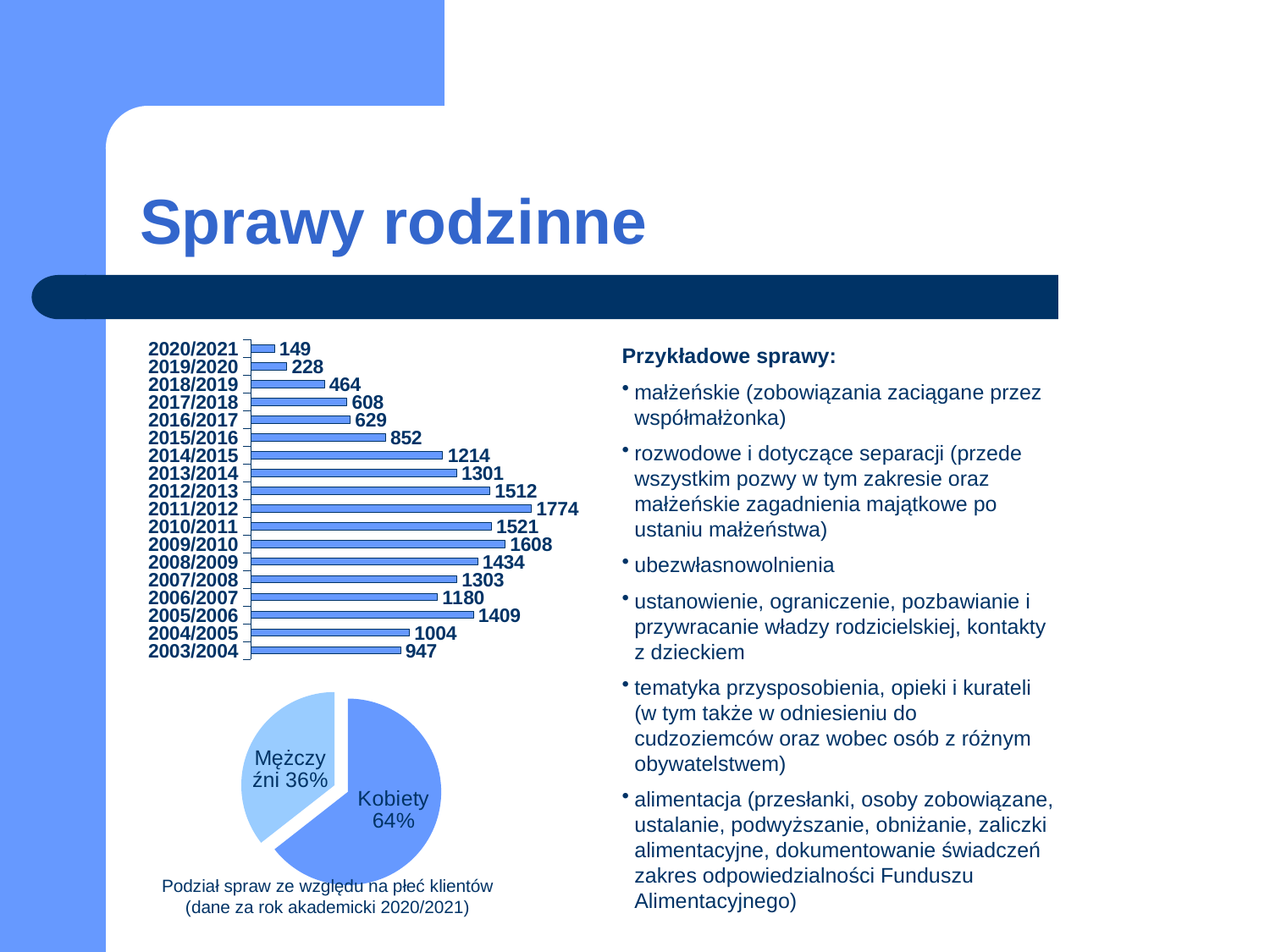
In the bar chart on the left, which academic year has the lowest value? 2020/2021 In the bar chart on the left, which academic year has the highest value? 2011/2012 In the pie chart at the bottom left, what share of cases is for Kobiety? 64% In the bar chart on the left, what is the difference between the values for 2009/2010 and 2008/2009? 174 In the bar chart on the left, which is larger, the value for 2005/2006 or the value for 2006/2007? 2005/2006 In the pie chart at the bottom left, what share of cases is for Mężczyźni? 36% In the bar chart on the left, what is the value for 2011/2012? 1774 What kind of chart is the chart at the top left of the slide? bar chart How many academic years are shown in the bar chart on the left? 18 In the bar chart on the left, what is the value for 2003/2004? 947 In the bar chart on the left, what is the value for 2020/2021? 149 What is the caption under the pie chart at the bottom left? Podział spraw ze względu na płeć klientów (dane za rok akademicki 2020/2021)